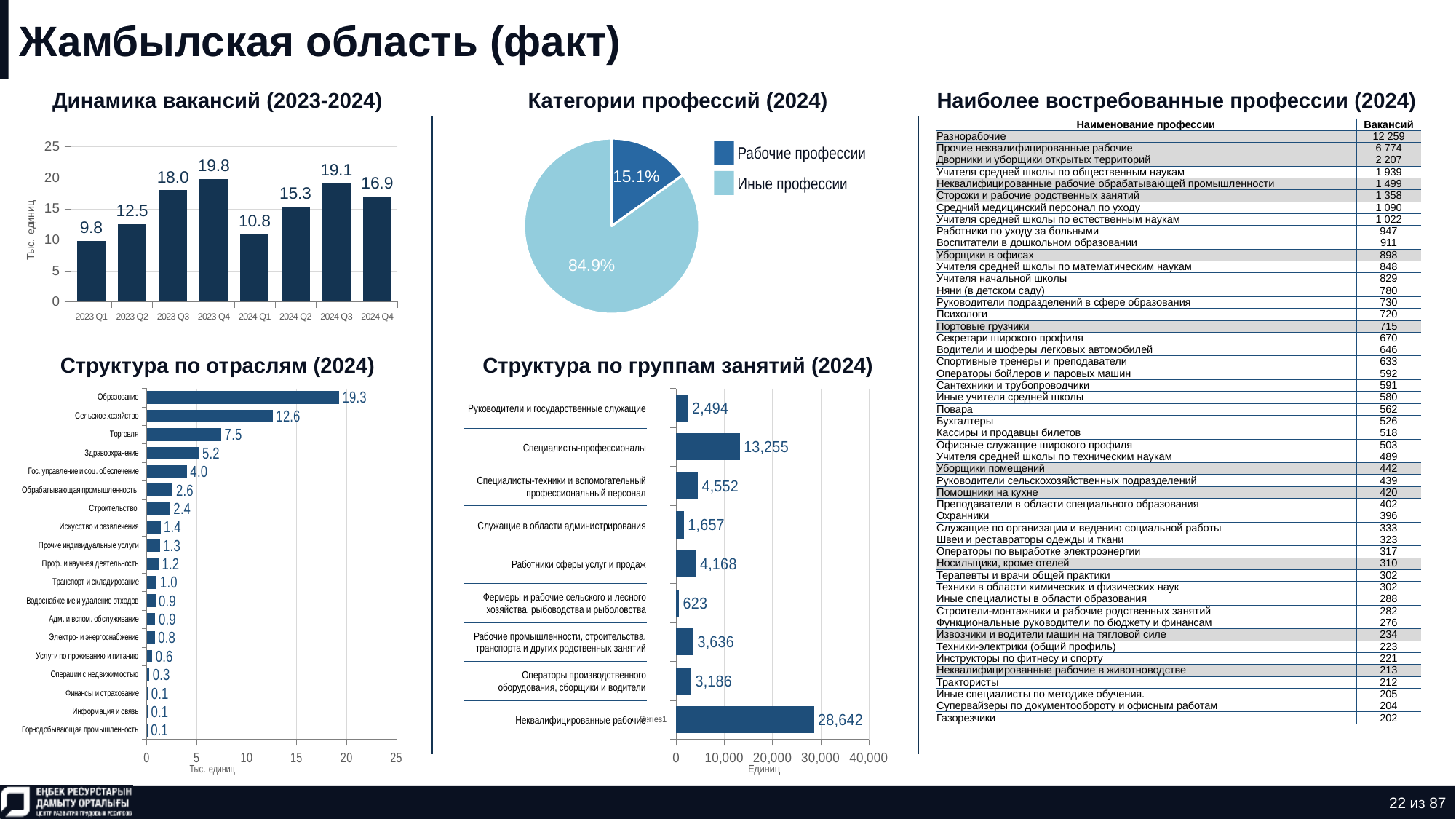
In the 'Структура по группам занятий (2024)' chart, what is the value for 'Специалисты-профессионалы'? 13,255 In the 'Структура по группам занятий (2024)' chart, what is the difference between 'Специалисты-профессионалы' and 'Руководители и государственные служащие'? 10,761 In the 'Динамика вакансий (2023-2024)' chart, how many quarters are plotted? 8 What type of chart is 'Категории профессий (2024)'? Pie chart In the 'Динамика вакансий (2023-2024)' chart, what is the difference between 2023 Q4 and 2023 Q1? 10.0 In the 'Структура по отраслям (2024)' chart, what is the value for 'Сельское хозяйство'? 12.6 In the 'Динамика вакансий (2023-2024)' chart, which quarter has the lowest value? 2023 Q1 In the 'Структура по отраслям (2024)' chart, which is larger: 'Торговля' or 'Здравоохранение'? Торговля In the 'Динамика вакансий (2023-2024)' chart, what is the value for 2023 Q4? 19.8 In the 'Категории профессий (2024)' chart, what share do 'Рабочие профессии' have? 15.1% In the 'Структура по группам занятий (2024)' chart, which group has the lowest value? Фермеры и рабочие сельского и лесного хозяйства, рыбоводства и рыболовства In the 'Структура по отраслям (2024)' chart, which industry has the highest value? Образование